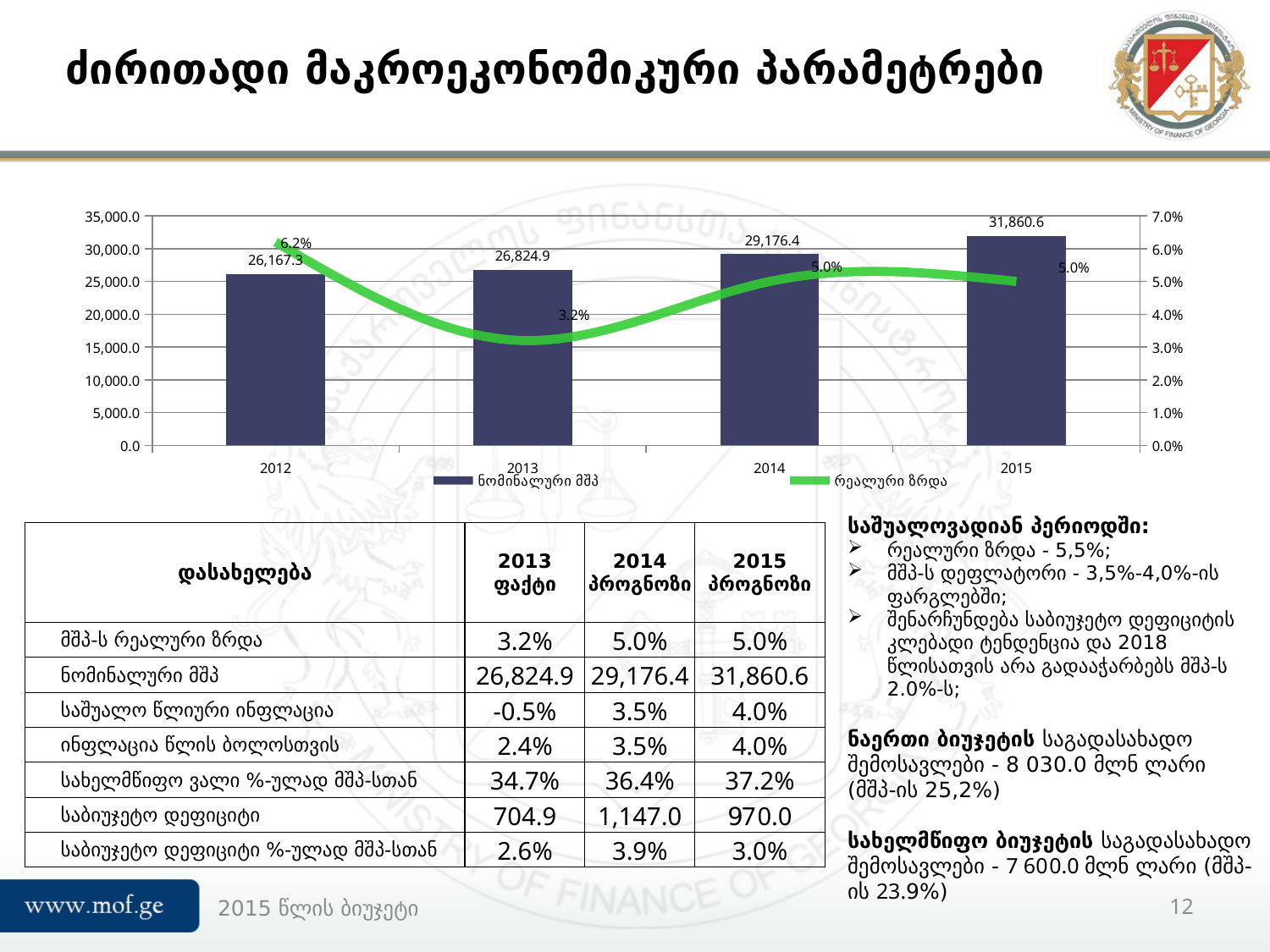
What is the value of the nominal GDP (ნომინალური მშპ) bar for 2015? 31,860.6 Which year has the highest nominal GDP (ნომინალური მშპ) bar? 2015 Which is larger, the nominal GDP bar for 2013 or for 2014? 2014 What is the difference between the nominal GDP bars for 2015 and 2014? 2,684.2 Is the nominal GDP bar for 2014 greater or less than 25,000.0? greater How many years are shown on the x axis of the chart? 4 What real growth (რეალური ზრდა) value is labelled on the line for 2012? 6.2% Do the nominal GDP (ნომინალური მშპ) bars rise or fall from 2012 to 2015? rise What is the value of the nominal GDP (ნომინალური მშპ) bar for 2012? 26,167.3 What real growth (რეალური ზრდა) value is labelled on the line for 2013? 3.2% How many series does the chart legend list? 2 Which year has the lowest real growth (რეალური ზრდა) value on the line? 2013